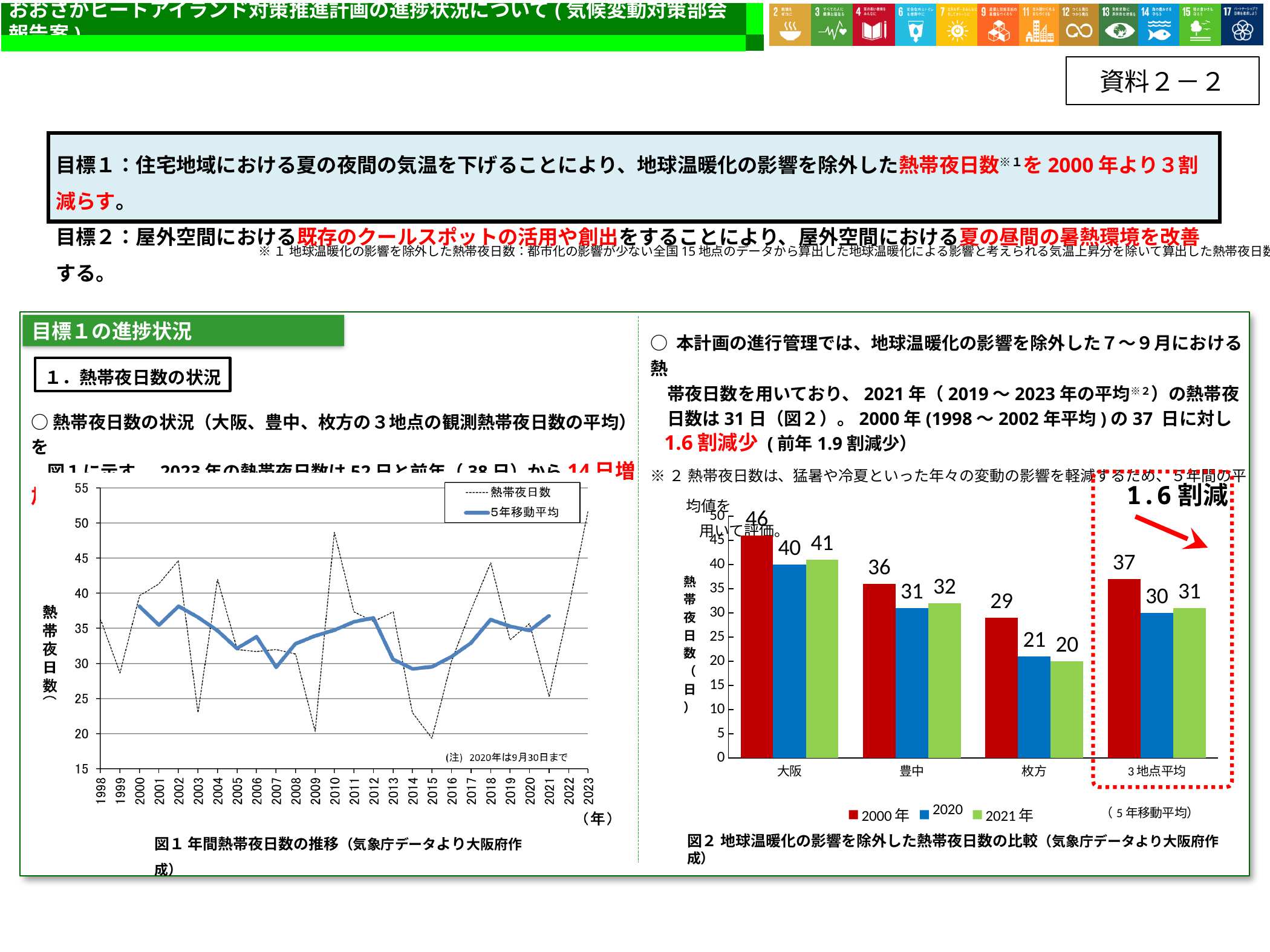
What kind of chart is Figure 1 (図１)? line chart In Figure 2 (図２), what is the value for 3地点平均 in the 2020 series? 30 In Figure 2 (図２), which is larger for 豊中: the 2020 value or the 2021年 value? 2021年 In Figure 2 (図２), what is the value for 大阪 in the 2000年 series? 46 In Figure 1 (図１), is the 熱帯夜日数 value for 2003 greater or less than 25? less In Figure 2 (図２), which category has the highest value in the 2000年 series? 大阪 In Figure 2 (図２), what is the difference between the 2000年 and 2021年 values for 3地点平均? 6 In Figure 2 (図２), how many categories are shown on the x axis? 4 In Figure 1 (図１), is the 熱帯夜日数 value for 2023 greater or less than 50? greater In Figure 2 (図２), which category has the lowest value in the 2021年 series? 枚方 In Figure 2 (図２), how many series does the legend list? 3 In Figure 2 (図２), what is the value for 枚方 in the 2021年 series? 20